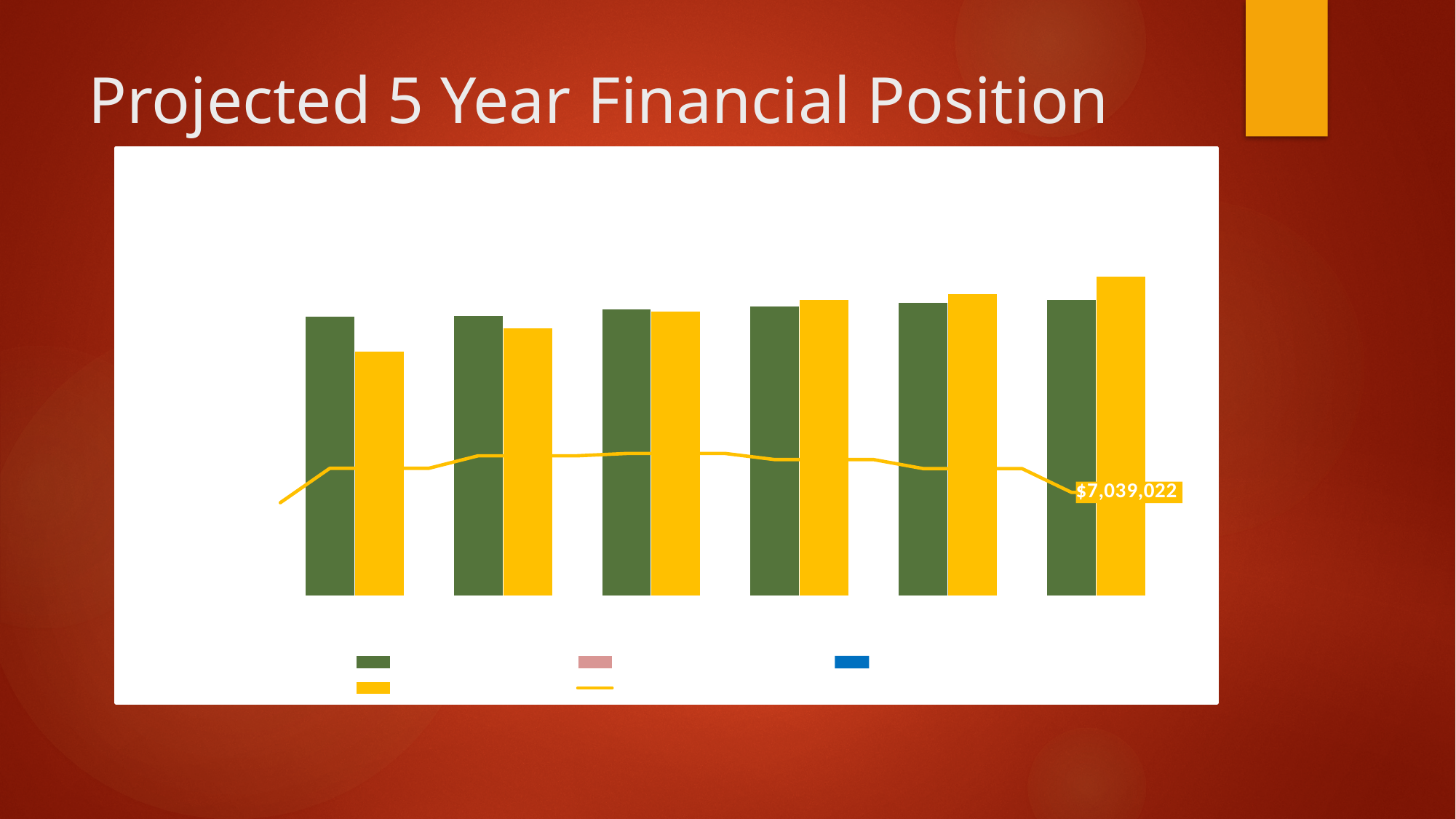
What two colours are used for the bars in the chart? Green and yellow What value is printed as the data label on the line at the rightmost point? $7,039,022 What is the title of the slide containing the chart? Projected 5 Year Financial Position Do the yellow bars rise or fall from left to right across the chart? Rise Which group of bars has the shortest yellow bar? The leftmost (first) group What kind of chart is shown on the slide? A bar chart with a line overlay In the leftmost group of bars, which bar is taller, the green one or the yellow one? The green one How many groups of bars are plotted in the chart? 6 In the rightmost group of bars, which bar is taller, the green one or the yellow one? The yellow one Which group of bars has the tallest yellow bar? The rightmost (sixth) group How many entries does the chart's legend show? 5